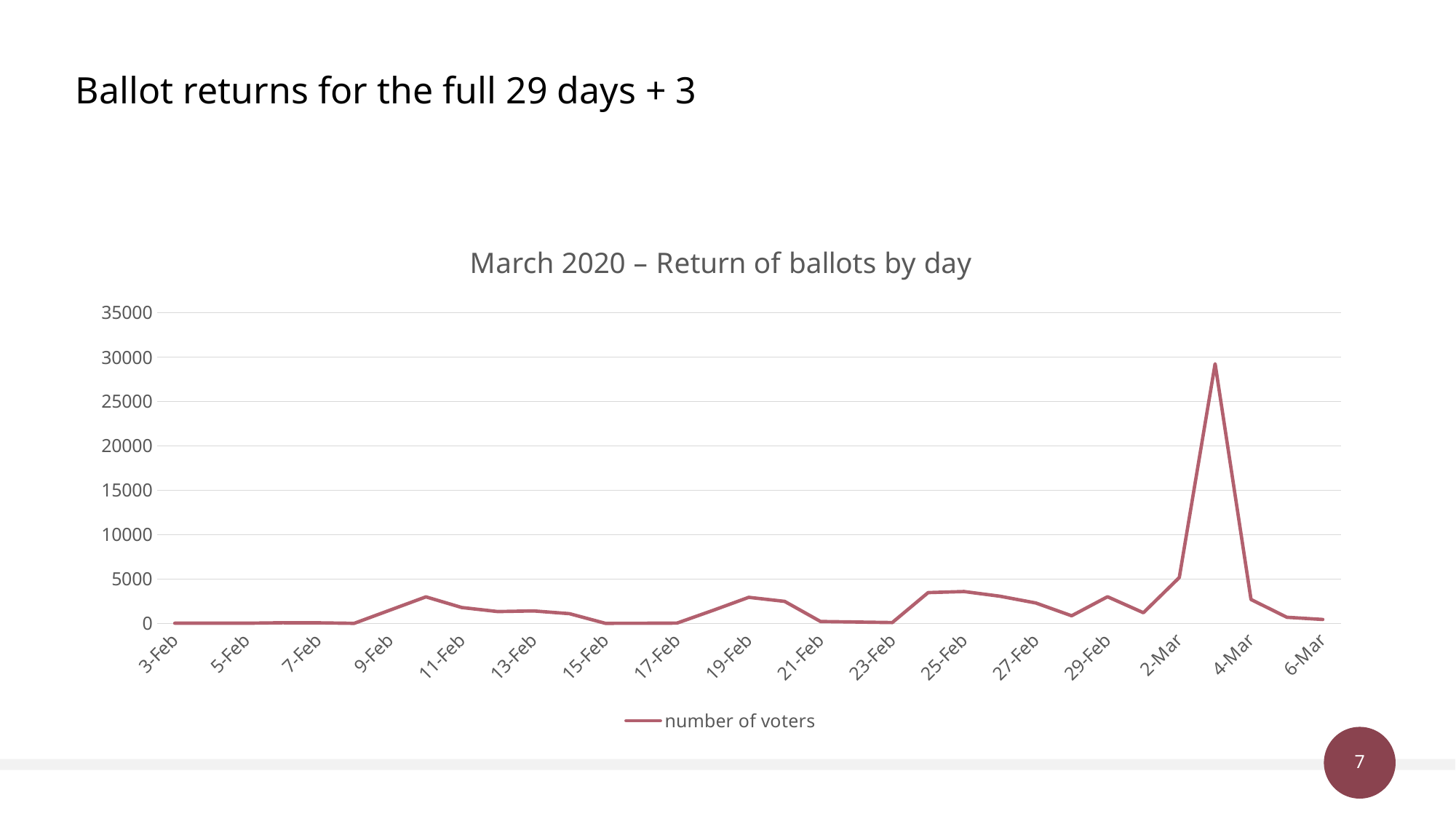
Is the value for 4-Mar greater or less than 5000? less Does the line rise or fall from 4-Mar to 6-Mar? fall What is the name of the series shown in the legend? number of voters Which has the larger value, 2-Mar or 6-Mar? 2-Mar What is the title of the chart? March 2020 – Return of ballots by day What type of chart is shown on the slide? line chart How many series does the legend list? 1 Is the highest point on the line greater or less than 25000? greater Is the value for 25-Feb greater or less than 5000? less Which has the larger value, 25-Feb or 17-Feb? 25-Feb How many date labels are shown on the x axis? 17